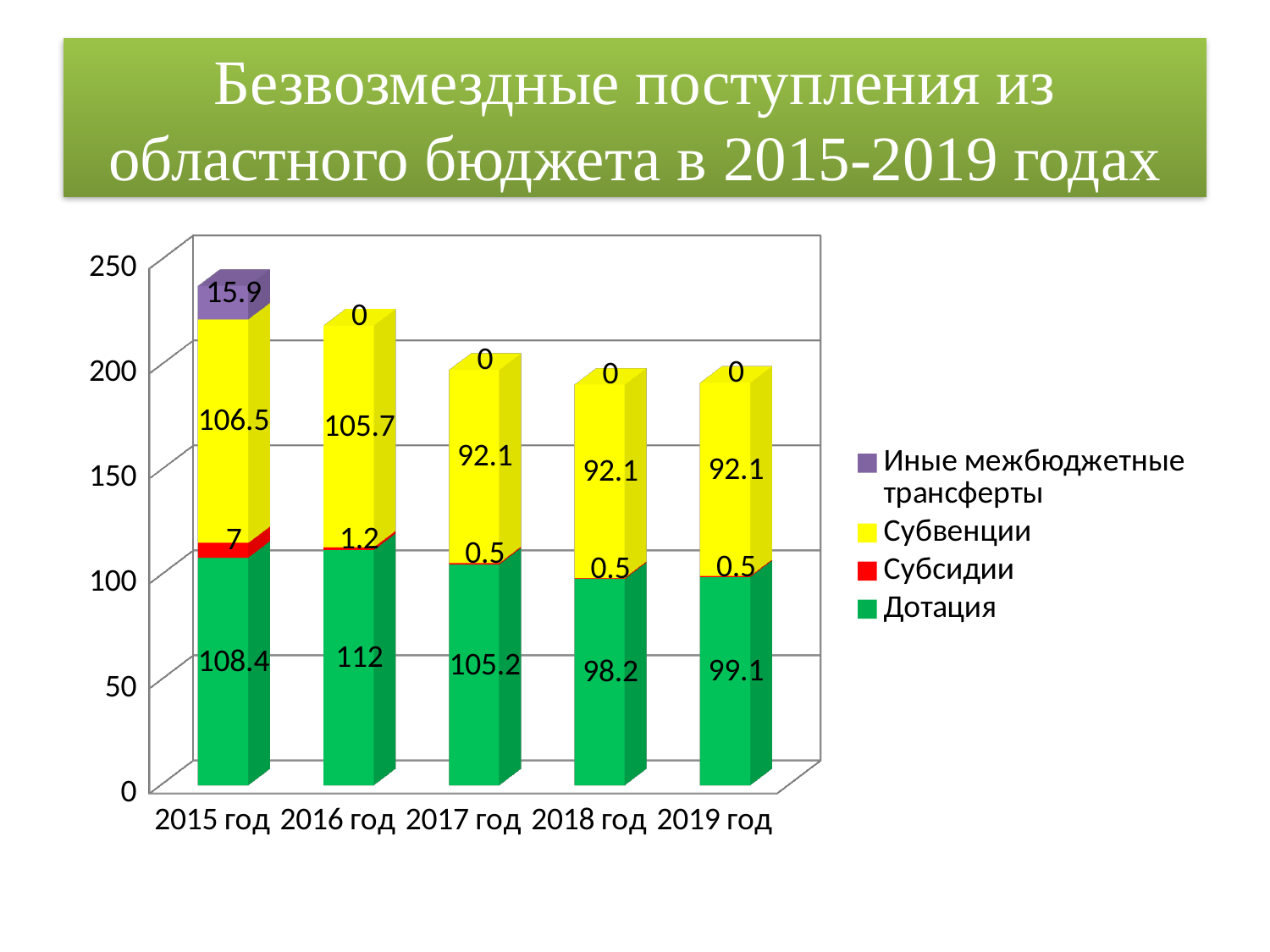
How many years are shown on the x axis? 5 What is the value of Иные межбюджетные трансферты for 2015 год? 15.9 What is the value of Субсидии for 2017 год? 0.5 Which is larger, the Субвенции value for 2016 год or for 2017 год? 2016 год What is the value of Дотация for 2016 год? 112 What is the value of Субвенции for 2015 год? 106.5 What is the total of the stacked bar for 2015 год? 237.8 Which year has the highest value of Дотация? 2016 год What kind of chart is shown on the slide? Stacked bar chart How many series does the legend list? 4 Which year has the lowest value of Дотация? 2018 год What is the difference between the Субсидии values for 2015 год and 2016 год? 5.8